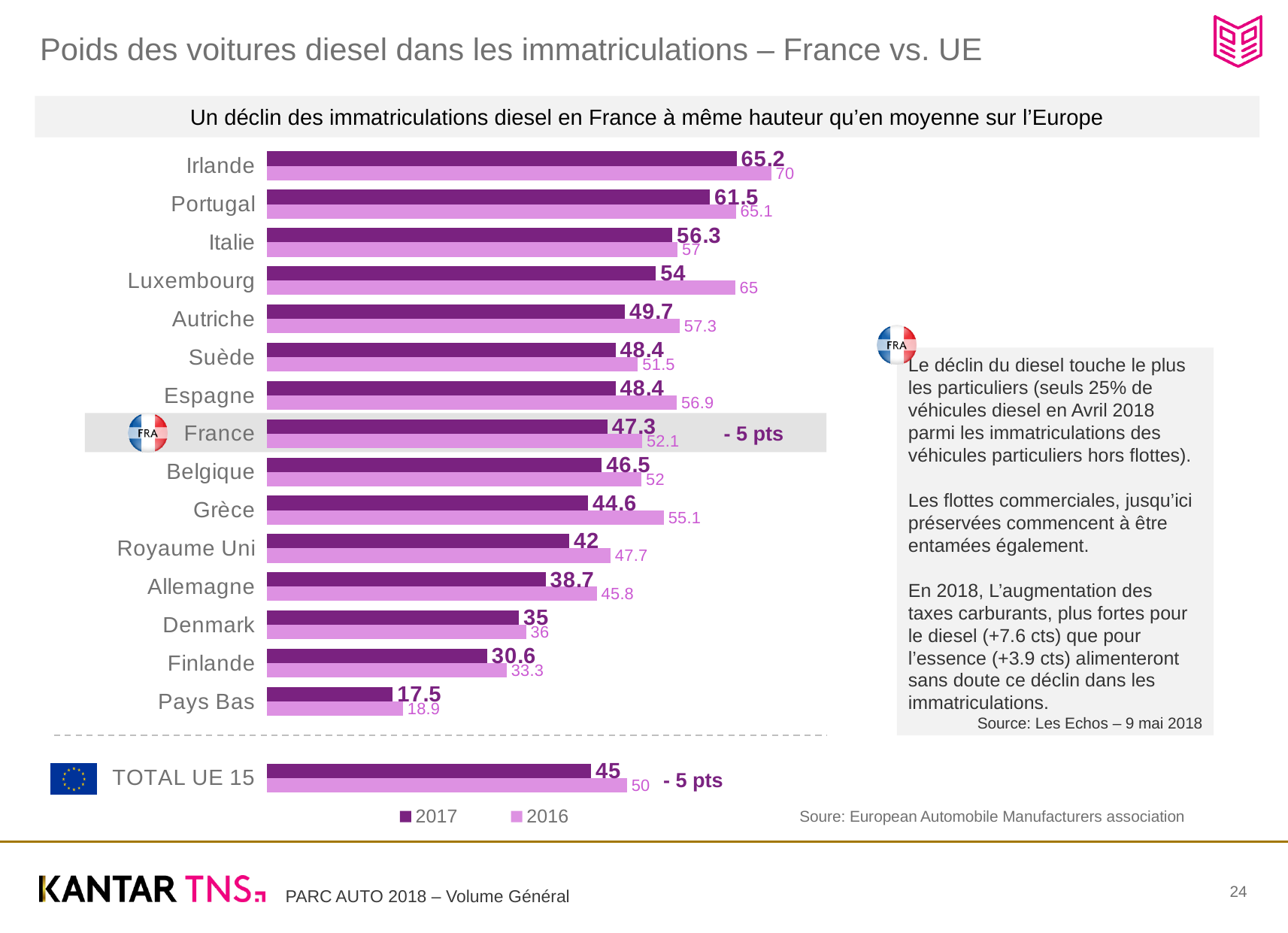
Which country has the highest 2017 value? Irlande What is the 2016 value for Luxembourg? 65 Which series does the darker purple colour represent in the legend? 2017 What is the 2017 value for TOTAL UE 15? 45 Which country has the lowest 2016 value? Pays Bas How many series does the legend list? 2 What is the difference between the 2016 and 2017 values for TOTAL UE 15? 5 What is the 2017 value for France? 47.3 Which is larger, the 2017 value for Allemagne or the 2017 value for Royaume Uni? Royaume Uni What is the difference between the 2016 and 2017 values for Grèce? 10.5 How many countries are listed in the chart, excluding TOTAL UE 15? 15 What kind of chart is shown on the slide? Bar chart